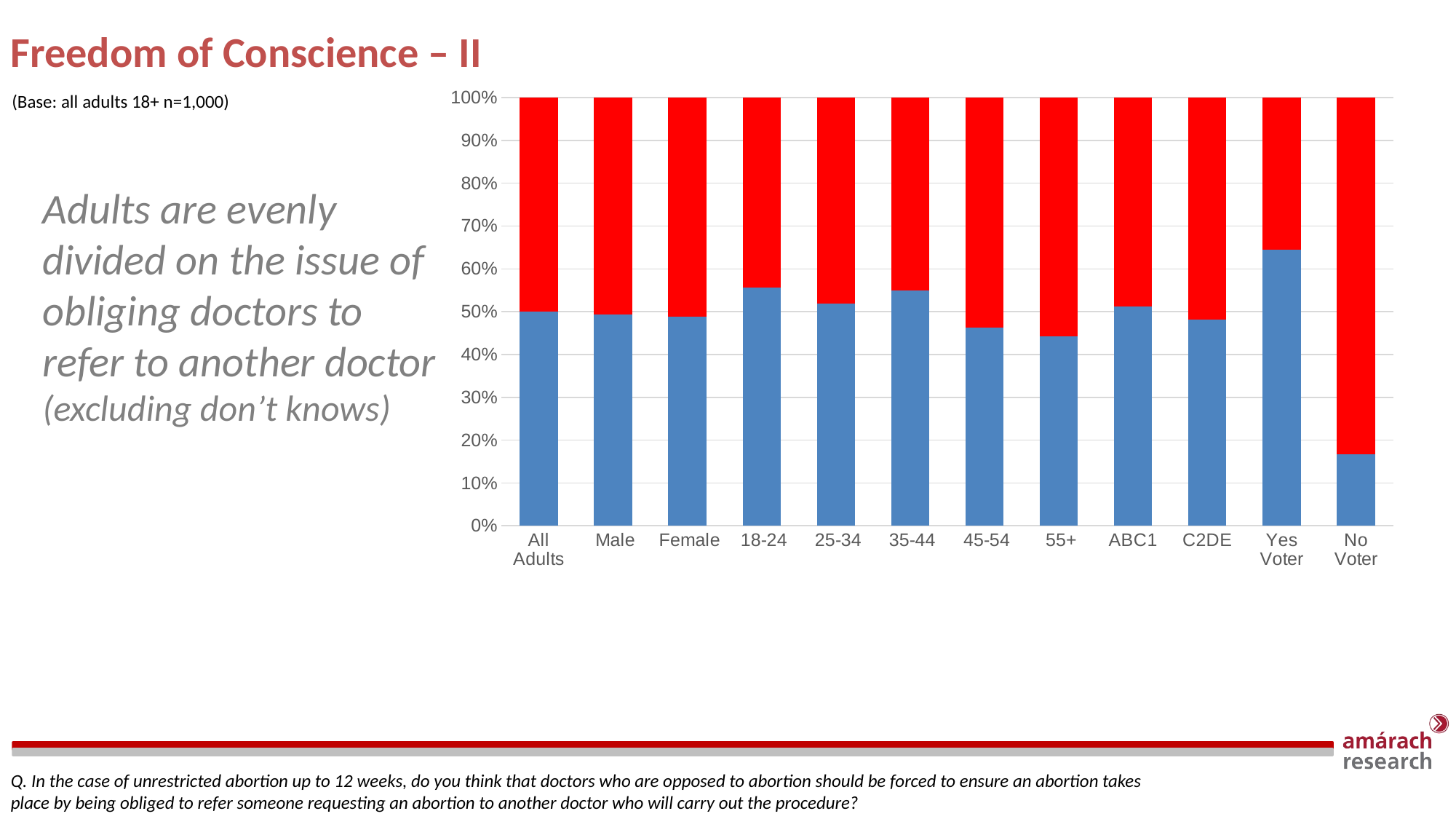
Which category has the tallest blue segment in the chart? Yes Voter How many categories are shown along the x axis of the chart? 12 What is the title of the slide containing the chart? Freedom of Conscience – II Which category has the shortest blue segment in the chart? No Voter Is the blue segment for 18-24 greater or less than 50%? greater What kind of chart is shown on the slide? Stacked bar chart Which has the larger red segment, No Voter or Yes Voter? No Voter What is the total height of the stacked bar for All Adults? 100% Is the blue segment for 55+ greater or less than 50%? less Is the blue segment for Yes Voter greater or less than 60%? greater Which has the larger blue segment, 18-24 or 55+? 18-24